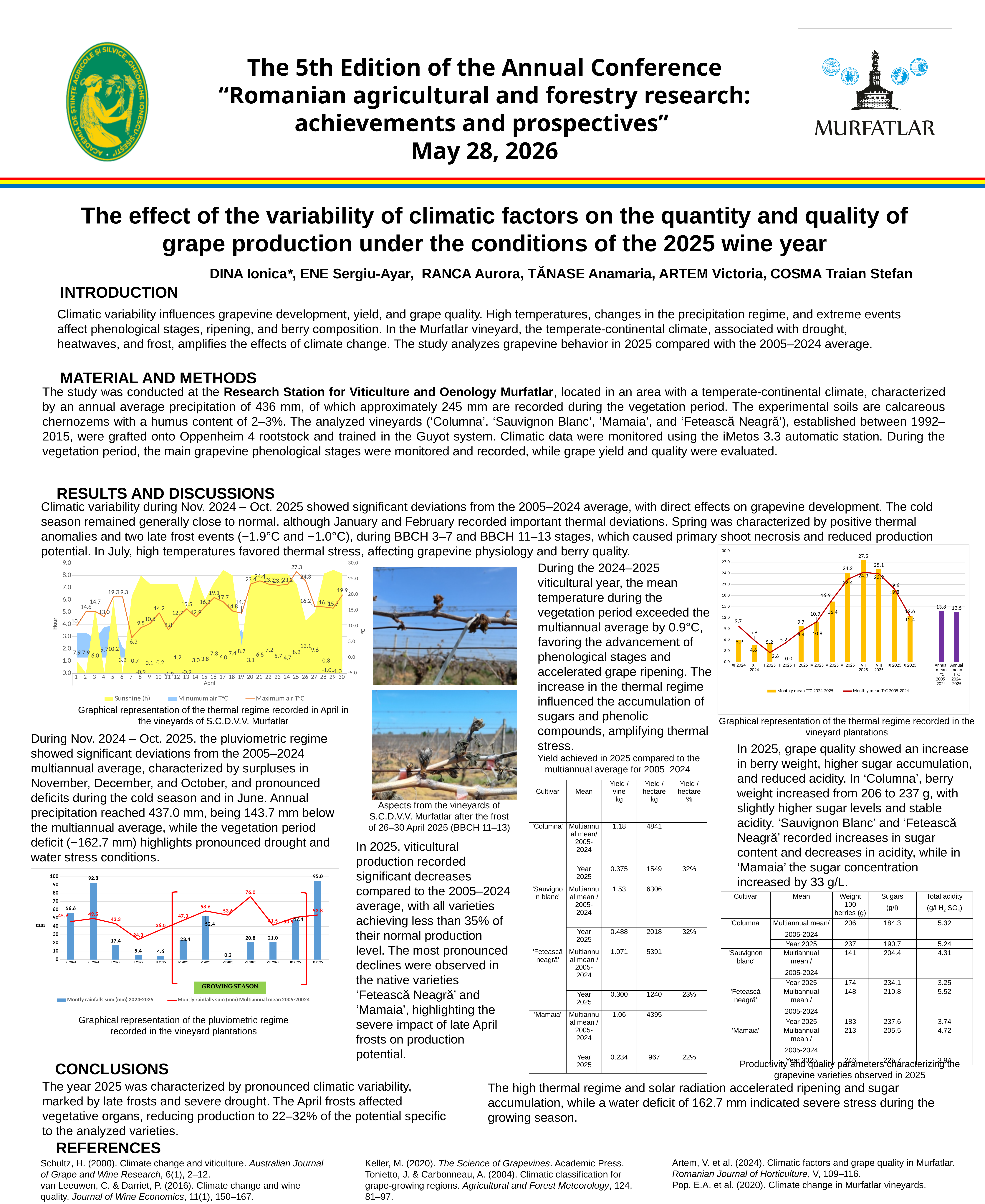
In the pluviometric regime chart, what is the monthly rainfall sum (mm) for XII 2024 in 2024-2025? 92.8 In the thermal regime chart for the vineyard plantations, for VI 2025, which is larger: the monthly mean T°C 2024-2025 or the multiannual mean 2005-2024? Monthly mean T°C 2024-2025 In the pluviometric regime chart, how many series does the legend list? 2 In the pluviometric regime chart, what kind of chart is used? bar and line chart In the thermal regime chart for the vineyard plantations, what is the annual mean T°C for 2005-2024? 13.8 In the thermal regime chart for the vineyard plantations, what is the monthly mean T°C for 2024-2025 in VII 2025? 27.5 In the pluviometric regime chart, which month has the highest monthly rainfall sum for 2024-2025? X 2025 In the pluviometric regime chart, which month has the lowest monthly rainfall sum for 2024-2025? VI 2025 In the pluviometric regime chart, what is the multiannual mean (2005-2024) rainfall value shown for VII 2025? 76.0 In the pluviometric regime chart, what is the difference between the 2024-2025 rainfall sums for X 2025 and XII 2024? 2.2 In the thermal regime chart for the vineyard plantations, which month has the highest multiannual monthly mean T°C (2005-2024)? VII 2025 In the April thermal regime chart, what is the highest maximum air temperature value shown? 27.3